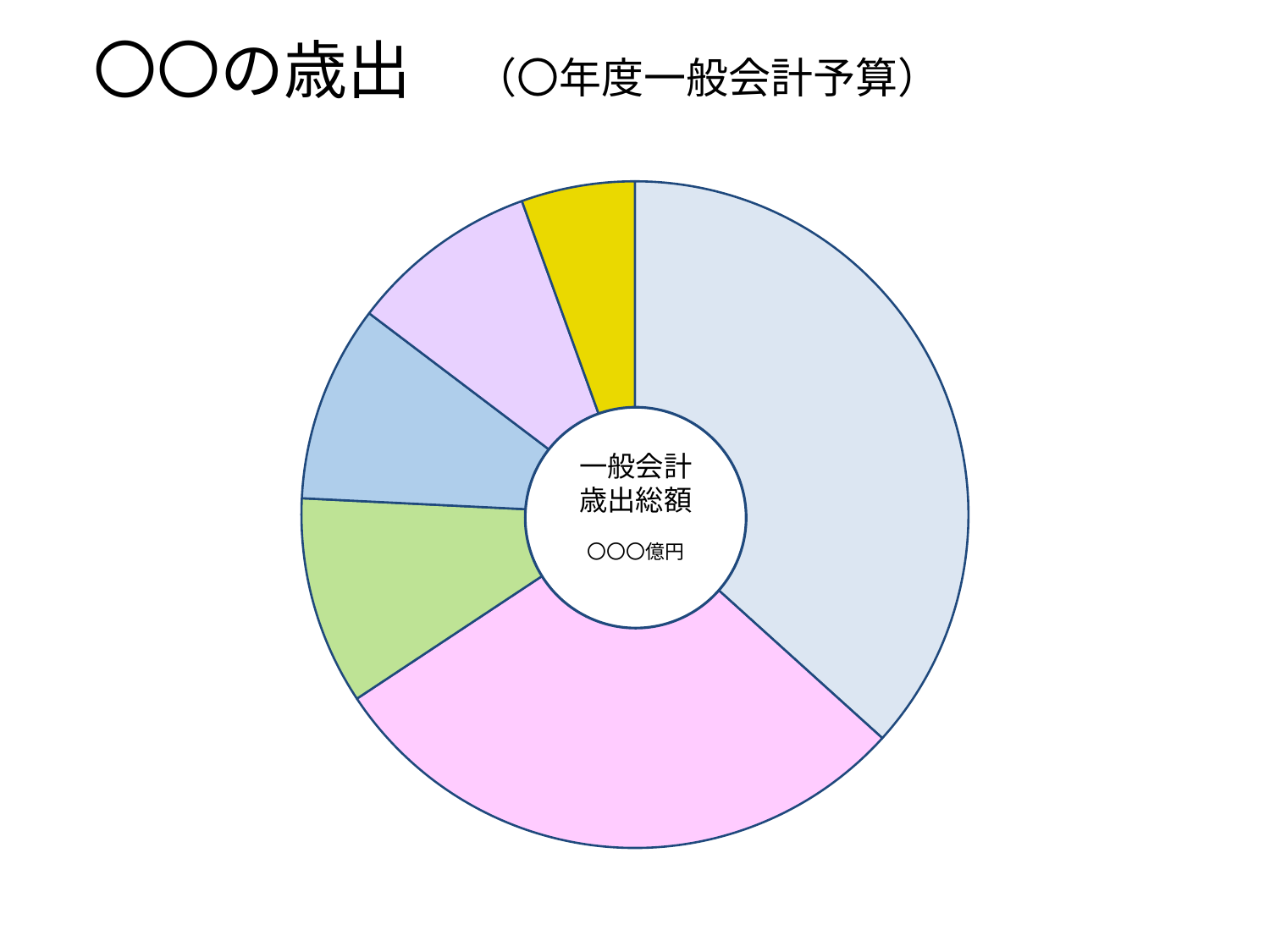
What text is written in the centre of the donut chart? 一般会計歳出総額 〇〇〇億円 Is the light blue slice greater or less than 25% of the pie? greater Which slice is larger, the lavender slice or the yellow slice? The lavender slice What kind of chart is shown on the slide? Pie (donut) chart How many slices does the pie chart have? 6 Which slice of the pie chart is the largest? The light blue slice on the right Which slice of the pie chart is the smallest? The yellow slice at the top What is the title of the slide? 〇〇の歳出（〇年度一般会計予算） Which slice is larger, the pink slice or the green slice? The pink slice Is the yellow slice greater or less than 10% of the pie? less